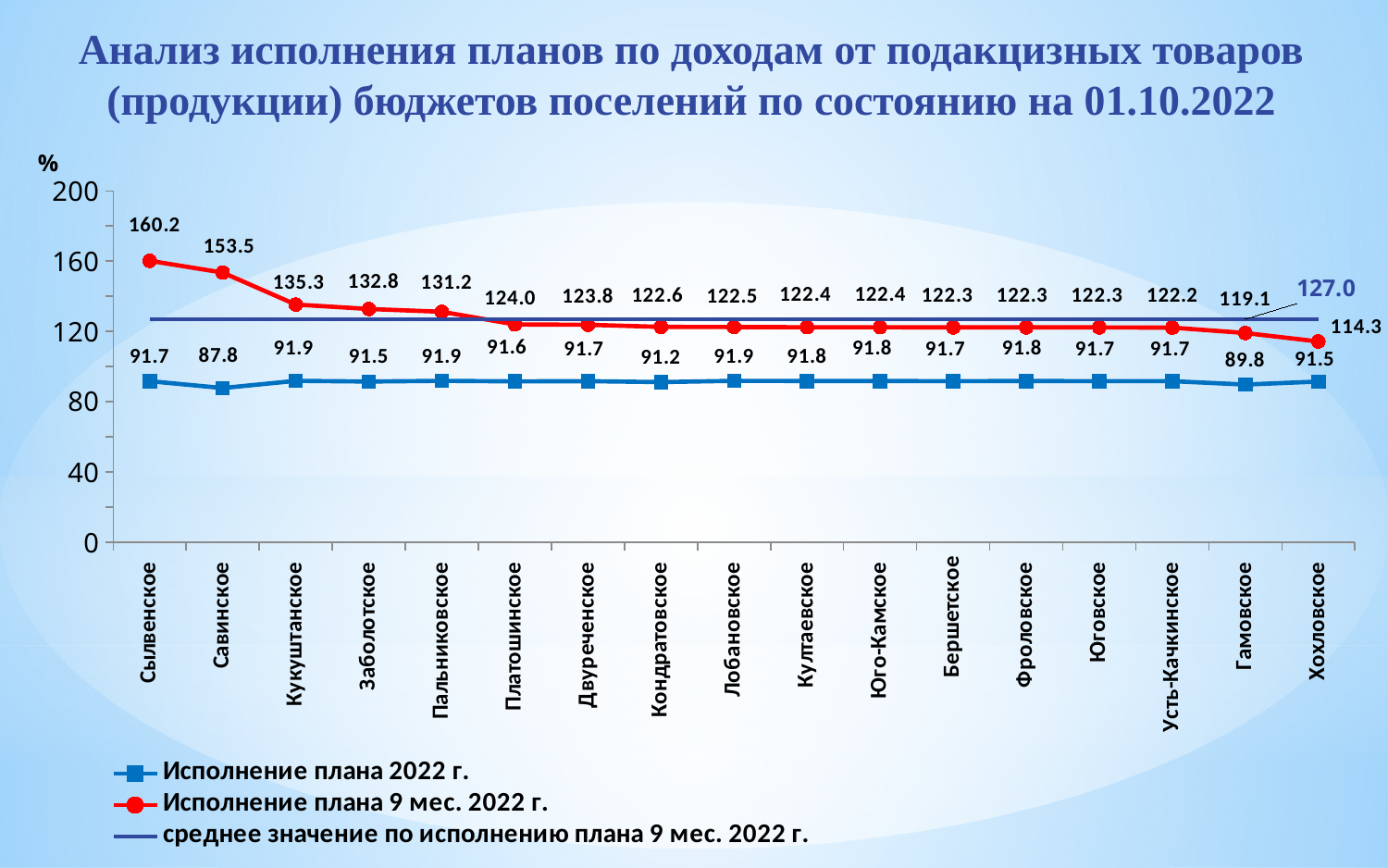
What is the value of the line 'среднее значение по исполнению плана 9 мес. 2022 г.'? 127.0 Which is larger for Кукуштанское: 'Исполнение плана 9 мес. 2022 г.' or 'Исполнение плана 2022 г.'? Исполнение плана 9 мес. 2022 г. What is the difference between the 'Исполнение плана 9 мес. 2022 г.' values for Сылвенское and Савинское? 6.7 What is the value of 'Исполнение плана 2022 г.' for Савинское? 87.8 What is the value of 'Исполнение плана 9 мес. 2022 г.' for Сылвенское? 160.2 How many series does the legend list? 3 How many settlements are shown on the x axis? 17 Which settlement has the highest value for 'Исполнение плана 9 мес. 2022 г.'? Сылвенское Does the 'Исполнение плана 9 мес. 2022 г.' series rise or fall from left to right along the x axis? Fall Which settlement has the lowest value for 'Исполнение плана 2022 г.'? Савинское What kind of chart is shown on the slide? Line chart What is the value of 'Исполнение плана 9 мес. 2022 г.' for Хохловское? 114.3